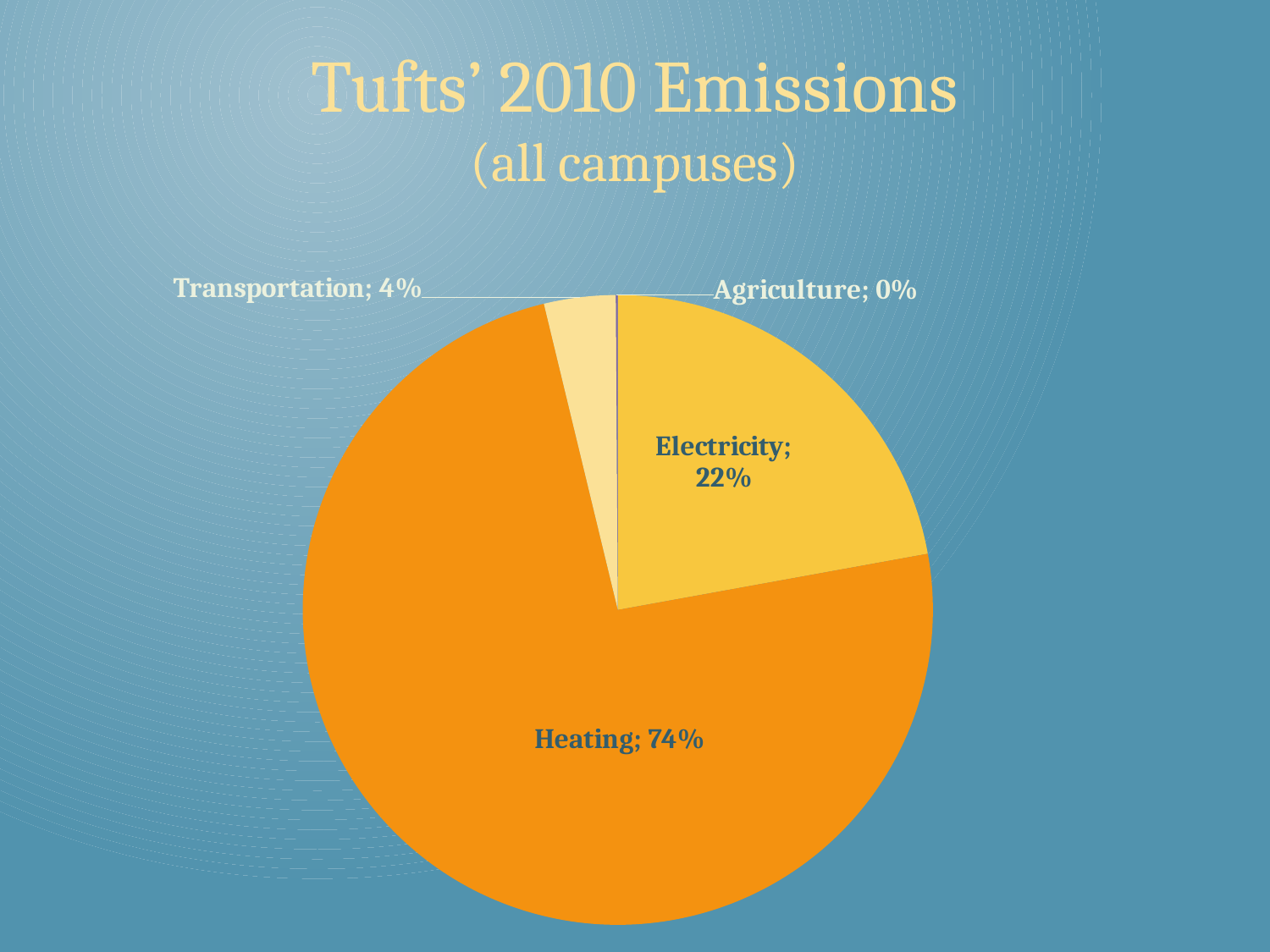
Which is larger, the share for Electricity or the share for Transportation? Electricity How many categories are shown in the pie chart? 4 Which category accounts for the smallest share of emissions? Agriculture What share of Tufts' 2010 emissions comes from Transportation? 4% What is the title of the chart? Tufts' 2010 Emissions (all campuses) What share of Tufts' 2010 emissions comes from Heating? 74% What share of Tufts' 2010 emissions comes from Electricity? 22% What is the combined share of Electricity and Transportation? 26% What is the difference in percentage points between Heating and Electricity? 52 What kind of chart is shown on the slide? pie chart What share of Tufts' 2010 emissions comes from Agriculture? 0% Which category accounts for the largest share of emissions? Heating